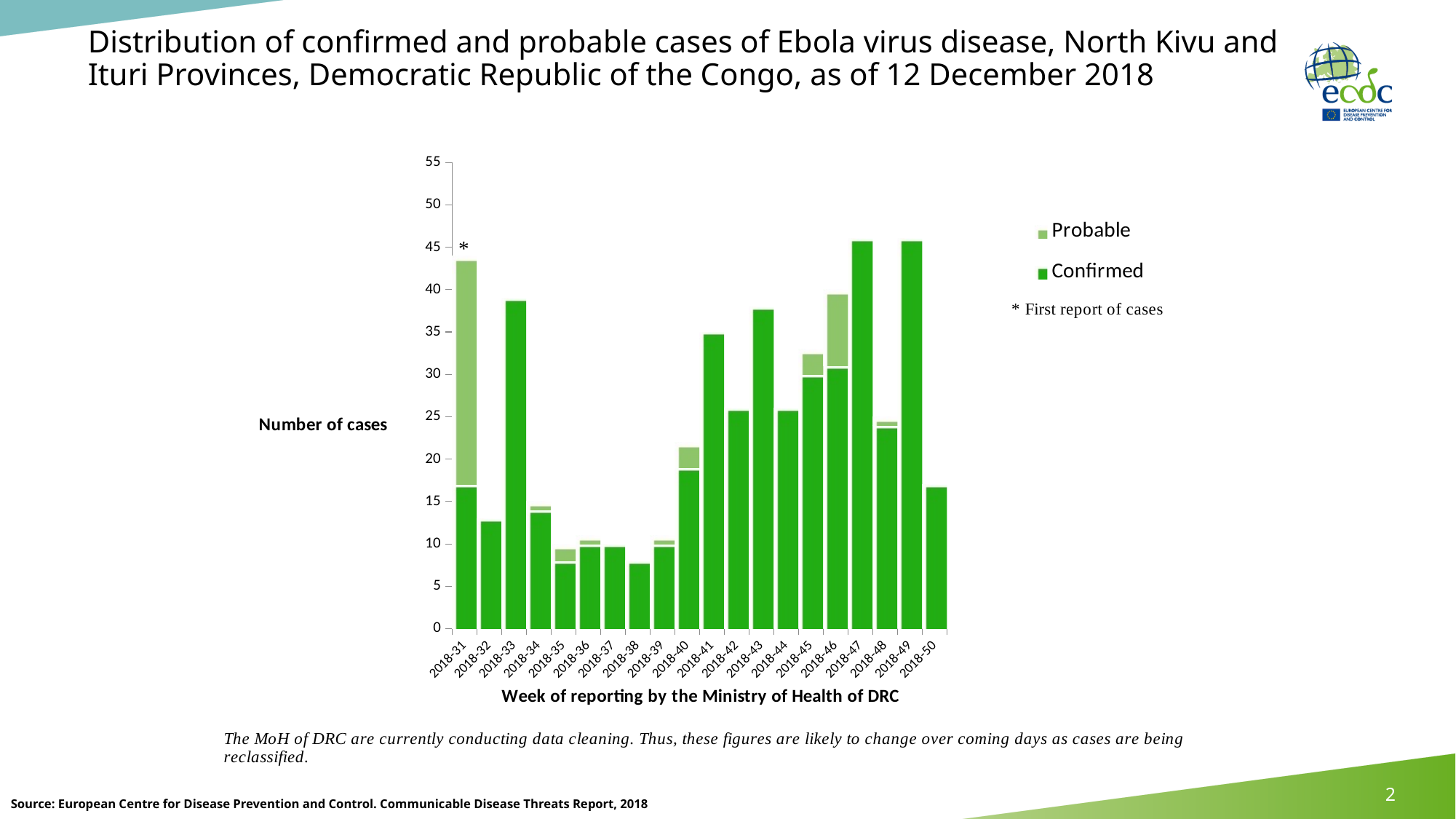
Which week has more cases, 2018-42 or 2018-43? 2018-43 Which reporting week has the lowest total number of cases? 2018-38 What does the asterisk next to the first bar indicate? First report of cases Is the number of confirmed cases for week 2018-40 greater or less than 20? less Do the total number of cases rise or fall from week 2018-38 to week 2018-41? rise What kind of chart is shown on the slide? Stacked bar chart Which week has more cases, 2018-32 or 2018-33? 2018-33 Is the number of confirmed cases for week 2018-33 greater or less than 35? greater Is the total number of cases for week 2018-31 greater or less than 40? greater How many reporting weeks are shown on the x axis? 20 How many series does the legend list? 2